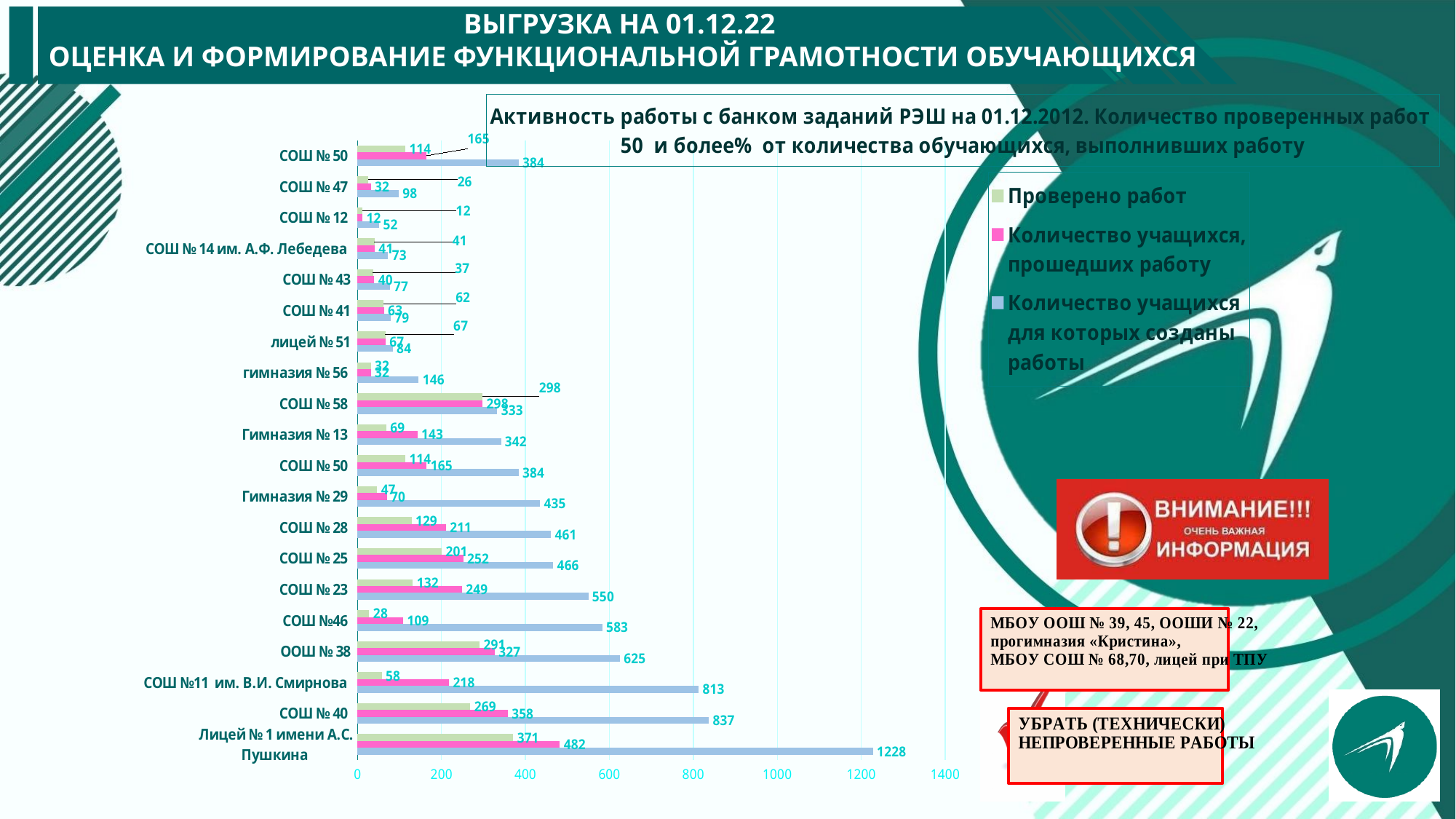
What is the value of "Количество учащихся, для которых созданы работы" for Лицей № 1 имени А.С. Пушкина? 1228 Which school has the lowest value for "Проверено работ"? СОШ № 12 What is the value of "Количество учащихся, прошедших работу" for Гимназия № 29? 70 What kind of chart is shown on the slide? bar chart What colour represents the series "Проверено работ" in the legend? green What is the value of "Проверено работ" for СОШ № 40? 269 How many series does the chart legend list? 3 For СОШ № 40, what is the difference between "Количество учащихся, прошедших работу" and "Проверено работ"? 89 For Лицей № 1 имени А.С. Пушкина, what is the difference between "Количество учащихся, прошедших работу" and "Проверено работ"? 111 Which school has the highest value for "Количество учащихся, для которых созданы работы"? Лицей № 1 имени А.С. Пушкина How many school categories are plotted on the chart? 20 Which has a higher value for "Проверено работ": ООШ № 38 or СОШ № 28? ООШ № 38